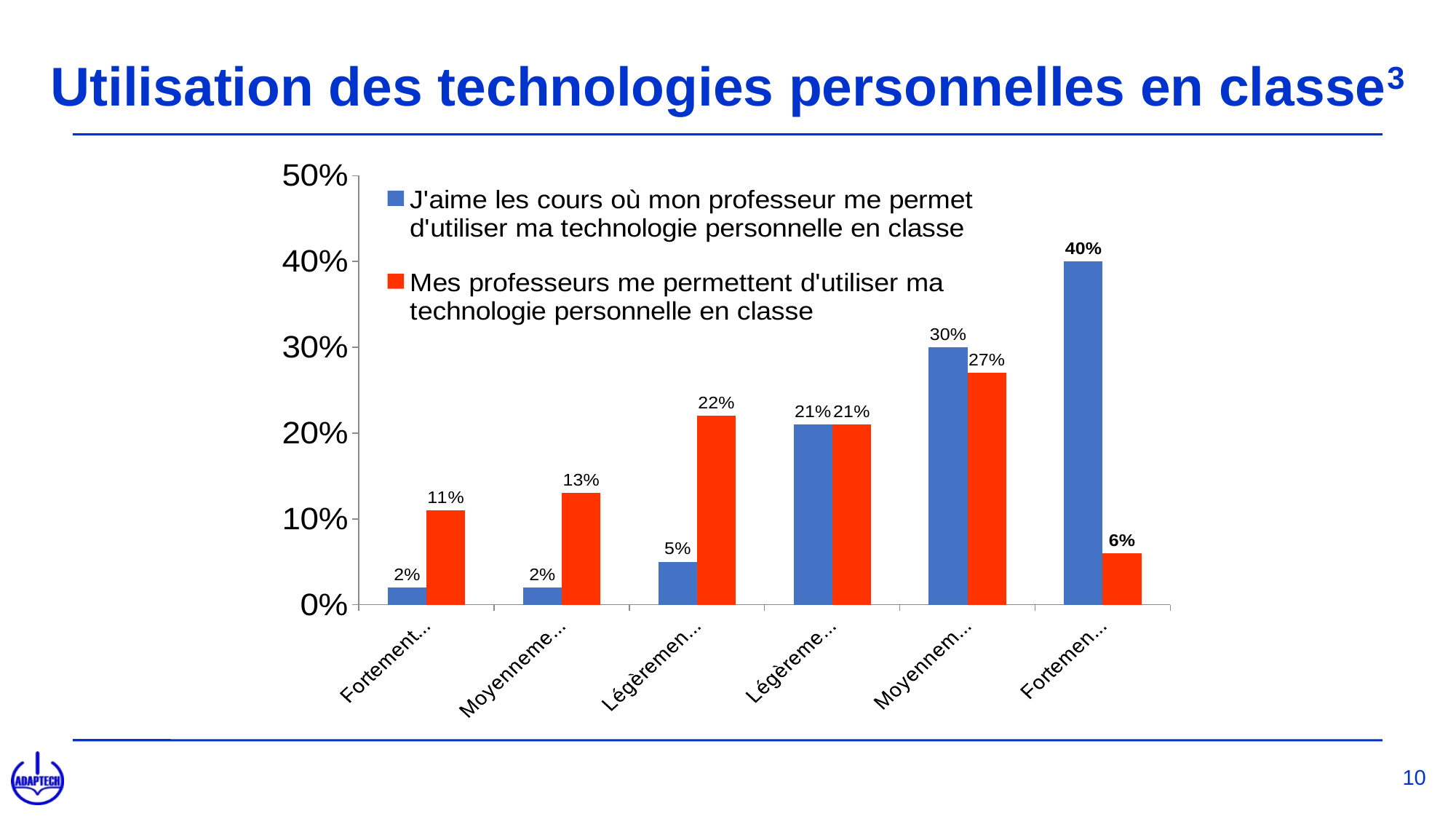
For the third category from the left, what is the value of the series "J'aime les cours où mon professeur me permet d'utiliser ma technologie personnelle en classe"? 5% Does the series "J'aime les cours où mon professeur me permet d'utiliser ma technologie personnelle en classe" rise or fall from left to right across the categories? Rise What is the highest value in the series "J'aime les cours où mon professeur me permet d'utiliser ma technologie personnelle en classe"? 40% For the rightmost category, what is the difference between the value for "J'aime les cours..." and the value for "Mes professeurs me permettent..."? 34 percentage points What is the highest value in the series "Mes professeurs me permettent d'utiliser ma technologie personnelle en classe"? 27% What colour represents the series "Mes professeurs me permettent d'utiliser ma technologie personnelle en classe"? Red What is the lowest value in the series "Mes professeurs me permettent d'utiliser ma technologie personnelle en classe"? 6% For the second category from the left, which series has the larger value? Mes professeurs me permettent d'utiliser ma technologie personnelle en classe What kind of chart is shown on the slide? Bar chart How many categories are shown along the x axis? 6 How many series does the legend list? 2 For the leftmost category, what is the value of the series "Mes professeurs me permettent d'utiliser ma technologie personnelle en classe"? 11%